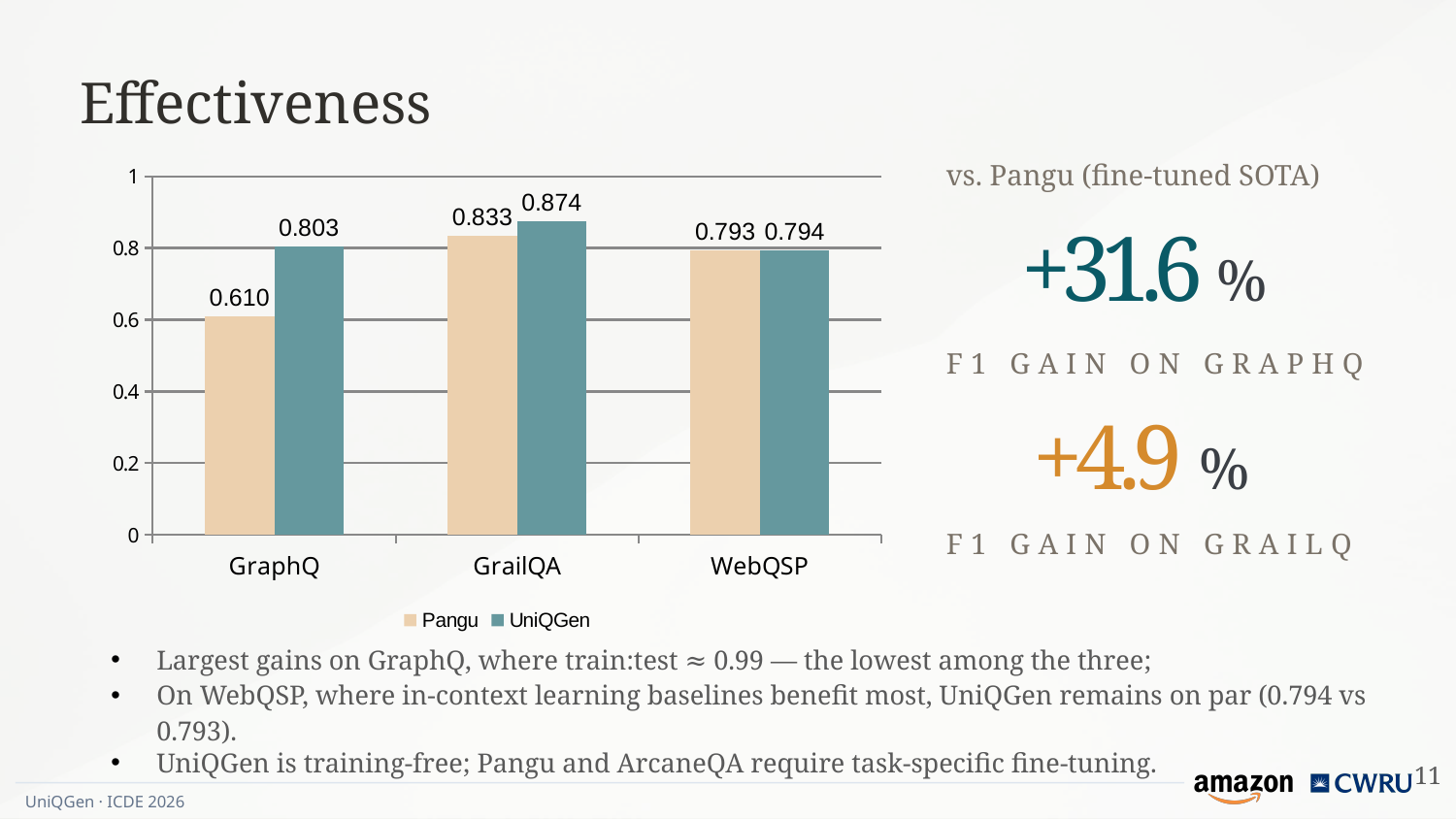
On which category does UniQGen have its highest value? GrailQA How many series does the legend list? 2 What is the value for Pangu on GrailQA? 0.833 On which category does Pangu have its lowest value? GraphQ What kind of chart is shown on the slide? Bar chart How many categories are shown on the x axis? 3 What is the value for UniQGen on WebQSP? 0.794 Which is larger on GraphQ, the Pangu value or the UniQGen value? UniQGen What is the difference between UniQGen and Pangu on GraphQ? 0.193 What is the value for Pangu on GraphQ? 0.610 What is the difference between UniQGen and Pangu on GrailQA? 0.041 What is the value for UniQGen on GrailQA? 0.874